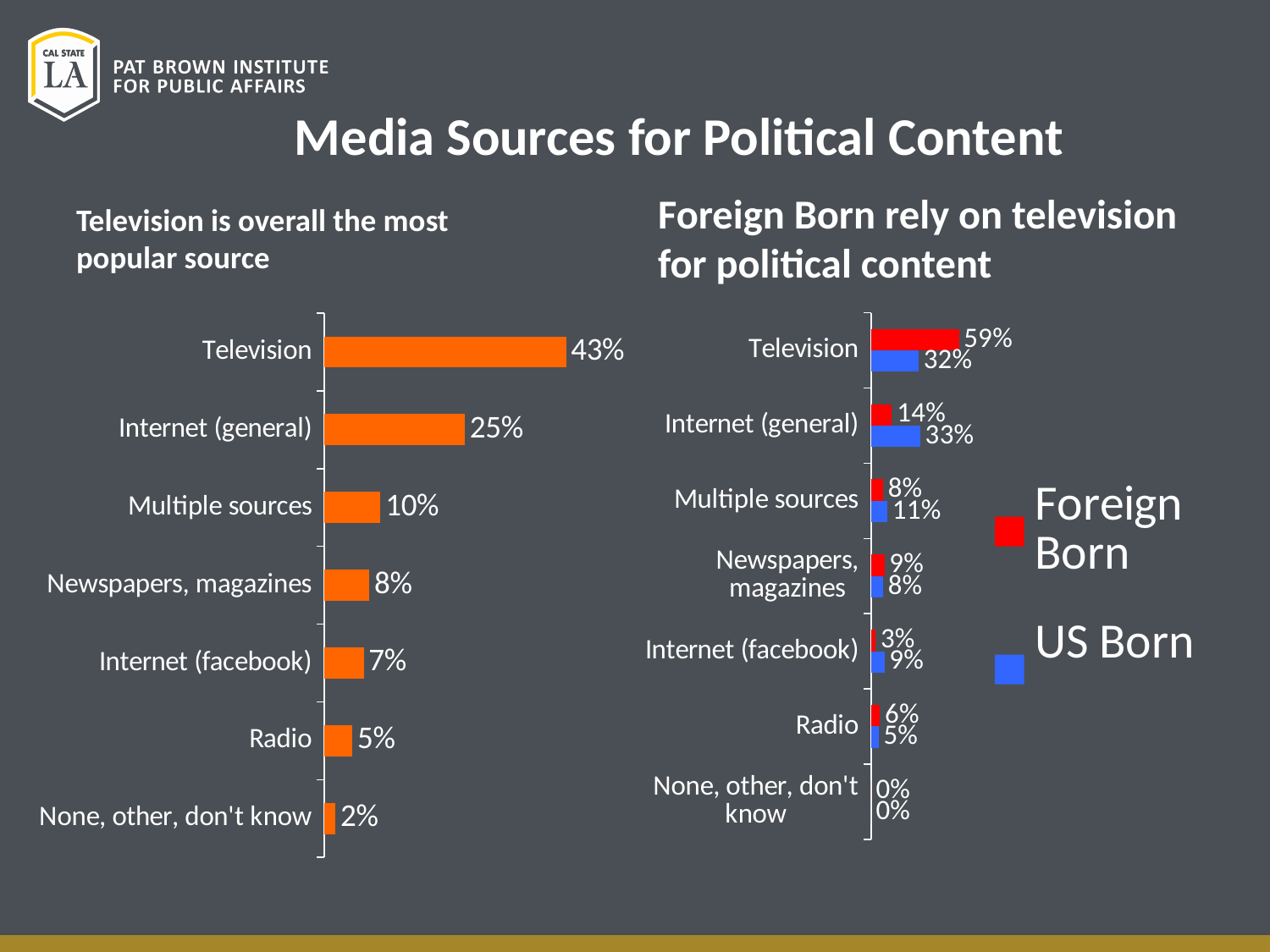
In the left chart, how many categories are shown? 7 What kind of chart is the left chart? Bar chart In the right chart, what is the difference between the Foreign Born and US Born values for Television? 27% In the right chart, which is larger for Internet (facebook): Foreign Born or US Born? US Born In the right chart (Foreign Born rely on television for political content), what is the Foreign Born value for Television? 59% In the right chart, what is the US Born value for Internet (general)? 33% In the left chart (Television is overall the most popular source), what is the value for Television? 43% In the left chart, what is the difference between Television and Internet (general)? 18% In the left chart, what is the value for Internet (general)? 25% In the right chart, which colour represents Foreign Born? Red In the right chart, how many series does the legend list? 2 In the left chart, which category has the lowest value? None, other, don't know